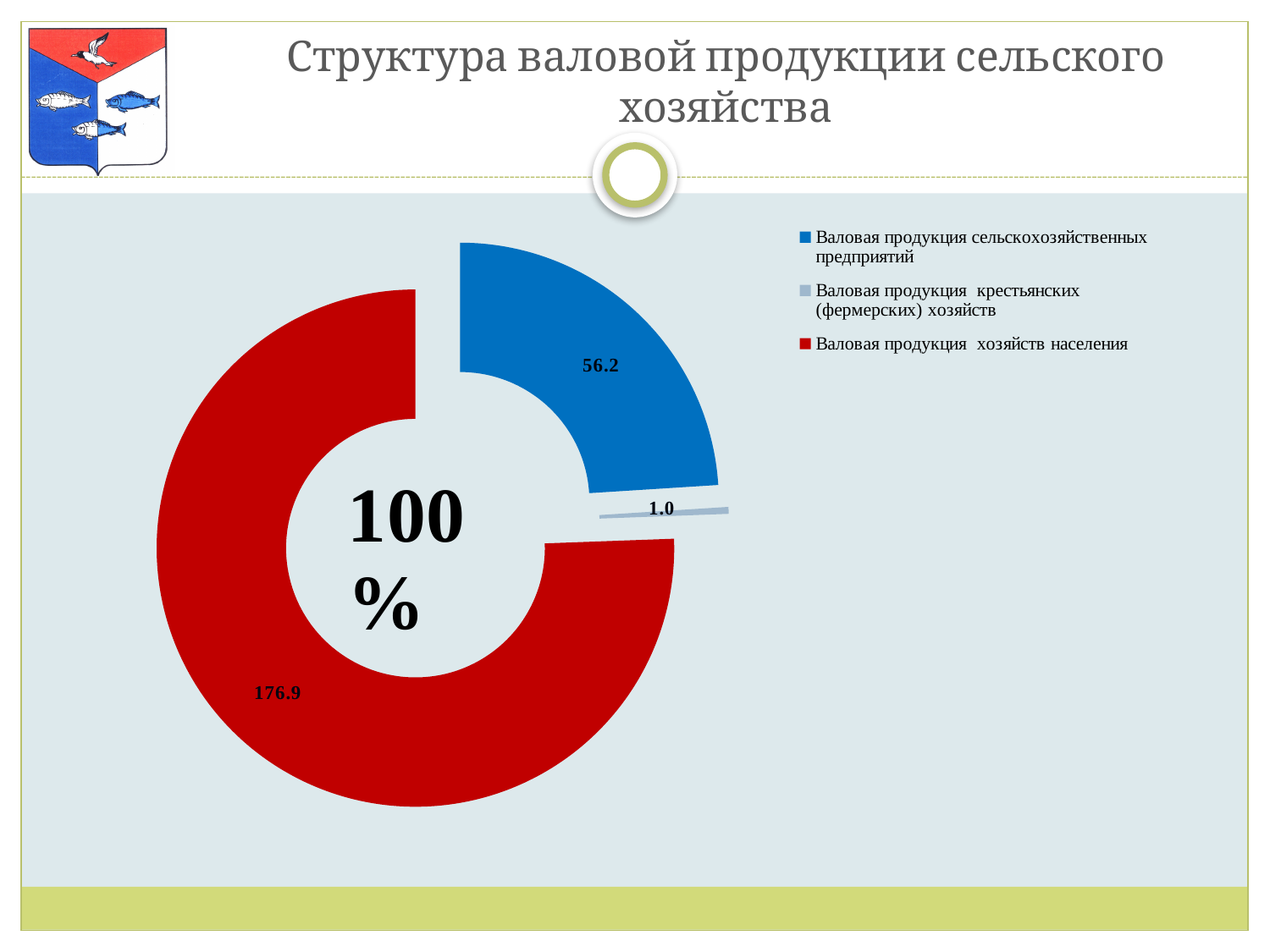
What is the difference between the value for хозяйств населения and the value for сельскохозяйственных предприятий? 120.7 How many slices does the chart have? 3 What value is shown for Валовая продукция крестьянских (фермерских) хозяйств? 1.0 How many entries does the legend list? 3 Which category has the smallest slice of the chart? Валовая продукция крестьянских (фермерских) хозяйств What value is shown for Валовая продукция сельскохозяйственных предприятий? 56.2 What is the total of the three values shown on the chart? 234.1 Which is larger: the value for сельскохозяйственных предприятий or the value for хозяйств населения? Валовая продукция хозяйств населения What value is shown for Валовая продукция хозяйств населения? 176.9 What kind of chart is shown on the slide? Pie (doughnut) chart Which category has the largest slice of the chart? Валовая продукция хозяйств населения What is the difference between the value for сельскохозяйственных предприятий and the value for крестьянских (фермерских) хозяйств? 55.2